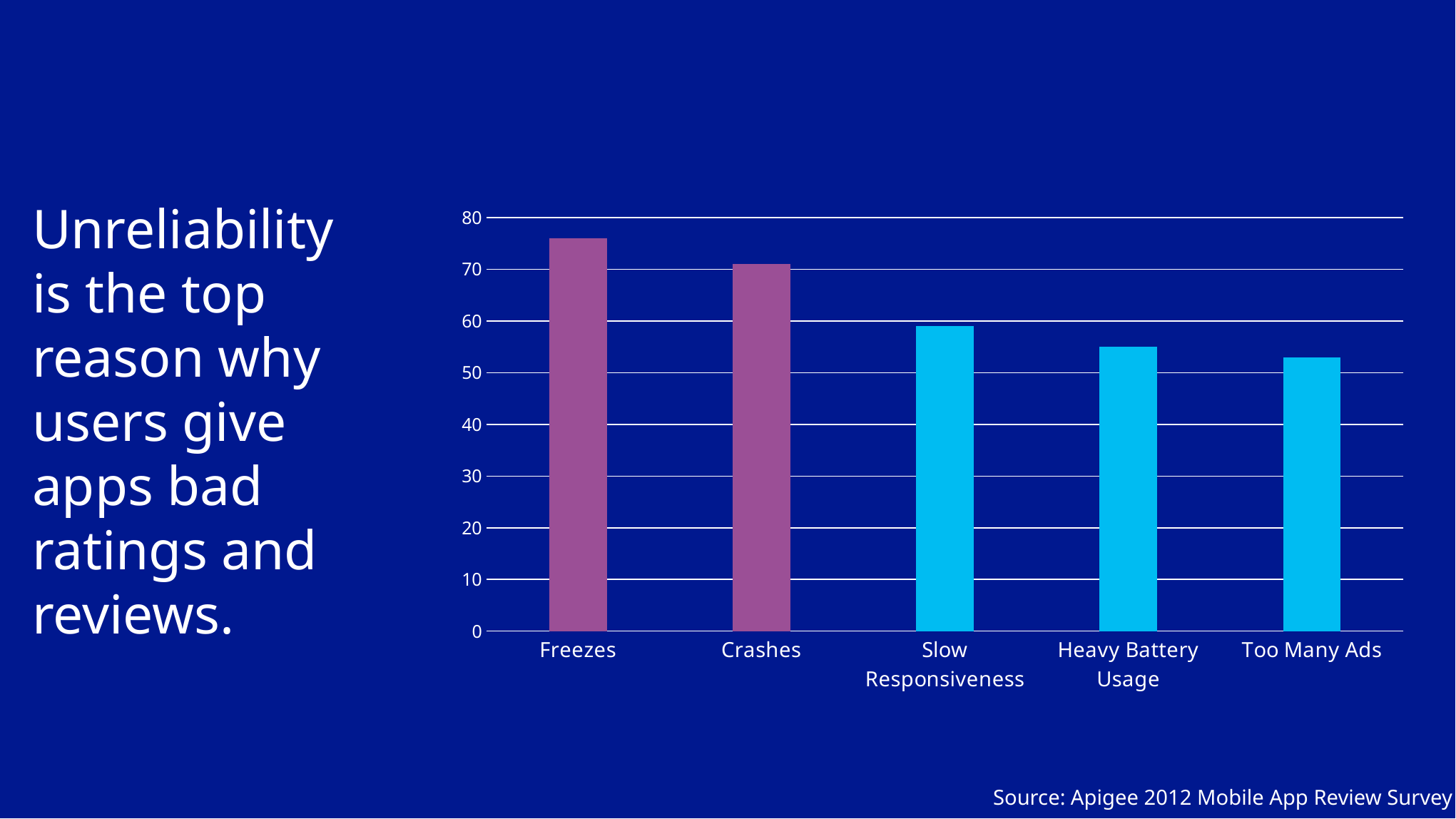
Do the bar values rise or fall from left to right across the categories? fall How many categories are shown on the x axis of the chart? 5 Is the value for Crashes greater or less than 80? less Is the value for Heavy Battery Usage greater or less than 60? less Is the value for Freezes greater or less than 70? greater What colour are the bars for Freezes and Crashes? purple Which is larger, the value for Freezes or the value for Crashes? Freezes Which is larger, the value for Crashes or the value for Slow Responsiveness? Crashes Which category has the highest bar in the chart? Freezes What kind of chart is shown on the slide? bar chart